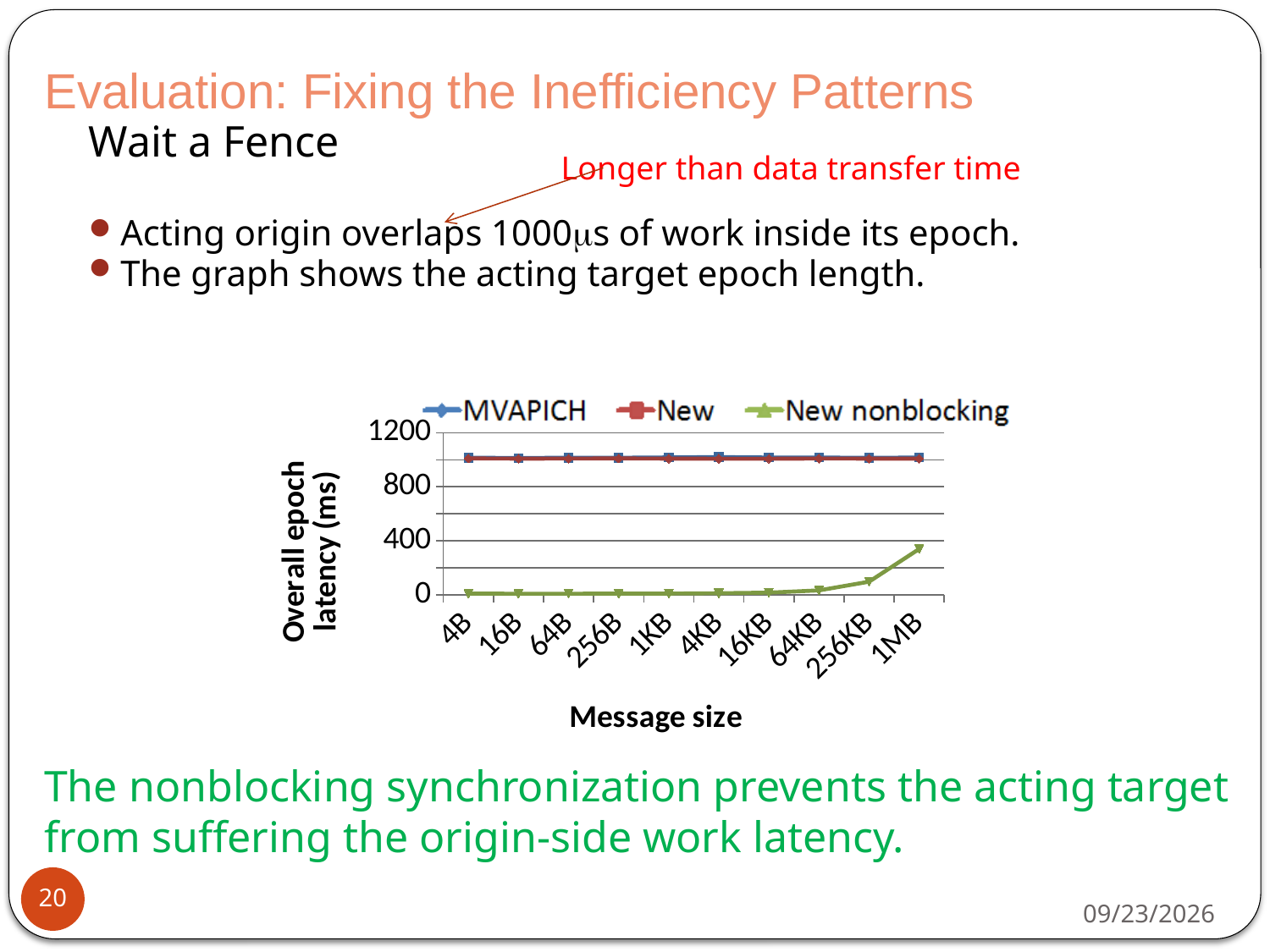
What is the label of the y axis? Overall epoch latency (ms) Which series are listed in the legend? MVAPICH, New, New nonblocking What kind of chart is shown on the slide? line chart Is the value for New nonblocking at 4B greater or less than 400? less Is the value for MVAPICH at 4B greater or less than 800? greater Which series has the lowest value at 1MB? New nonblocking At 1MB, which is larger: MVAPICH or New nonblocking? MVAPICH How many message sizes are shown on the x axis? 10 Does the New nonblocking series rise or fall as message size increases from 64KB to 1MB? rise How many series does the legend list? 3 Is the value for New nonblocking at 1MB greater or less than 400? less